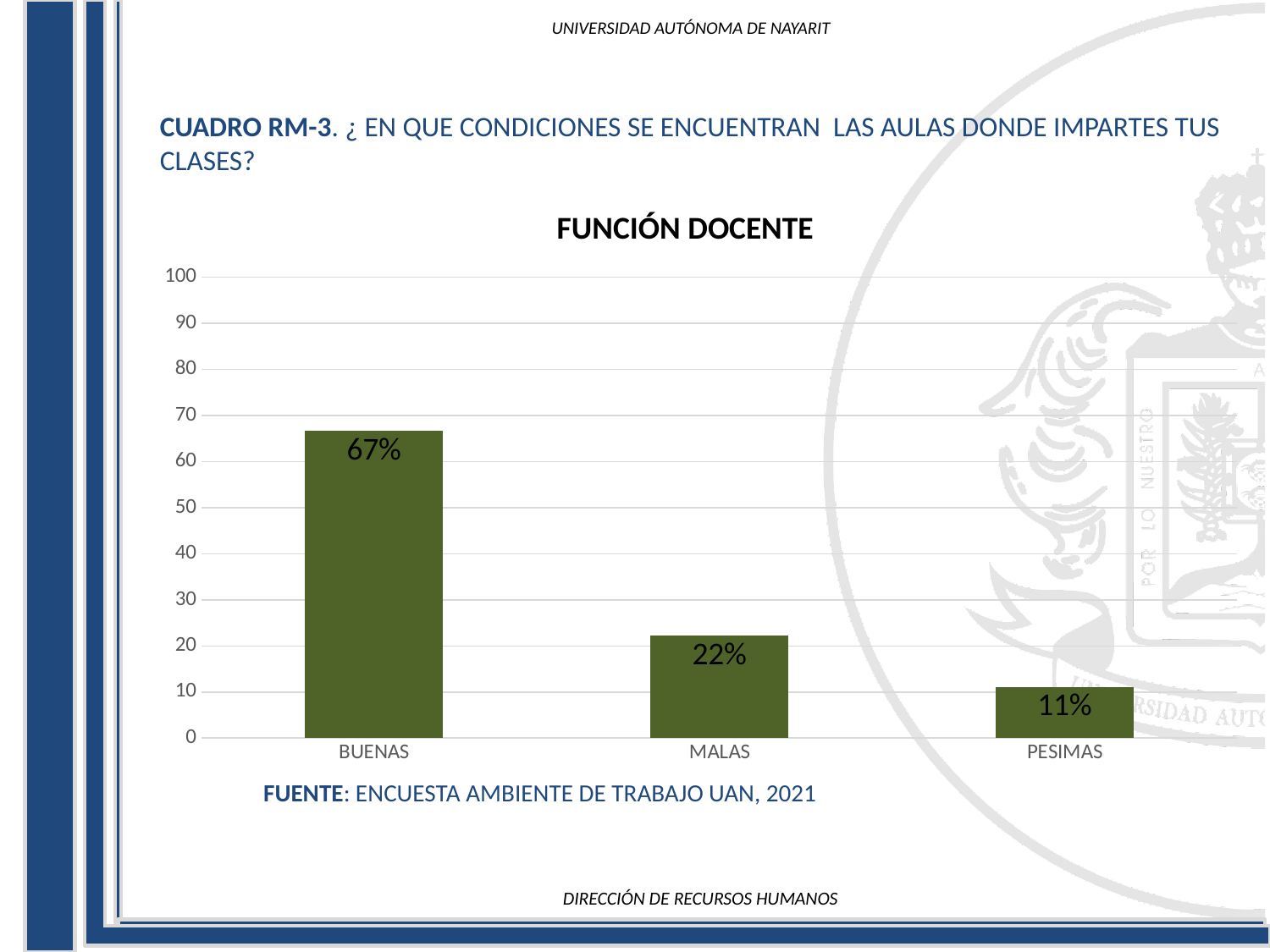
What kind of chart is shown on the slide? bar chart Is the value for BUENAS greater or less than 50? greater Which category has the lowest value? PESIMAS Which category has the highest value? BUENAS How many categories are shown on the x axis? 3 Which is larger, the value for MALAS or the value for PESIMAS? MALAS What is the title of the chart? FUNCIÓN DOCENTE What is the difference between the values for BUENAS and MALAS? 45% What is the value for BUENAS? 67% What is the value for MALAS? 22% What is the difference between the values for MALAS and PESIMAS? 11% What is the value for PESIMAS? 11%